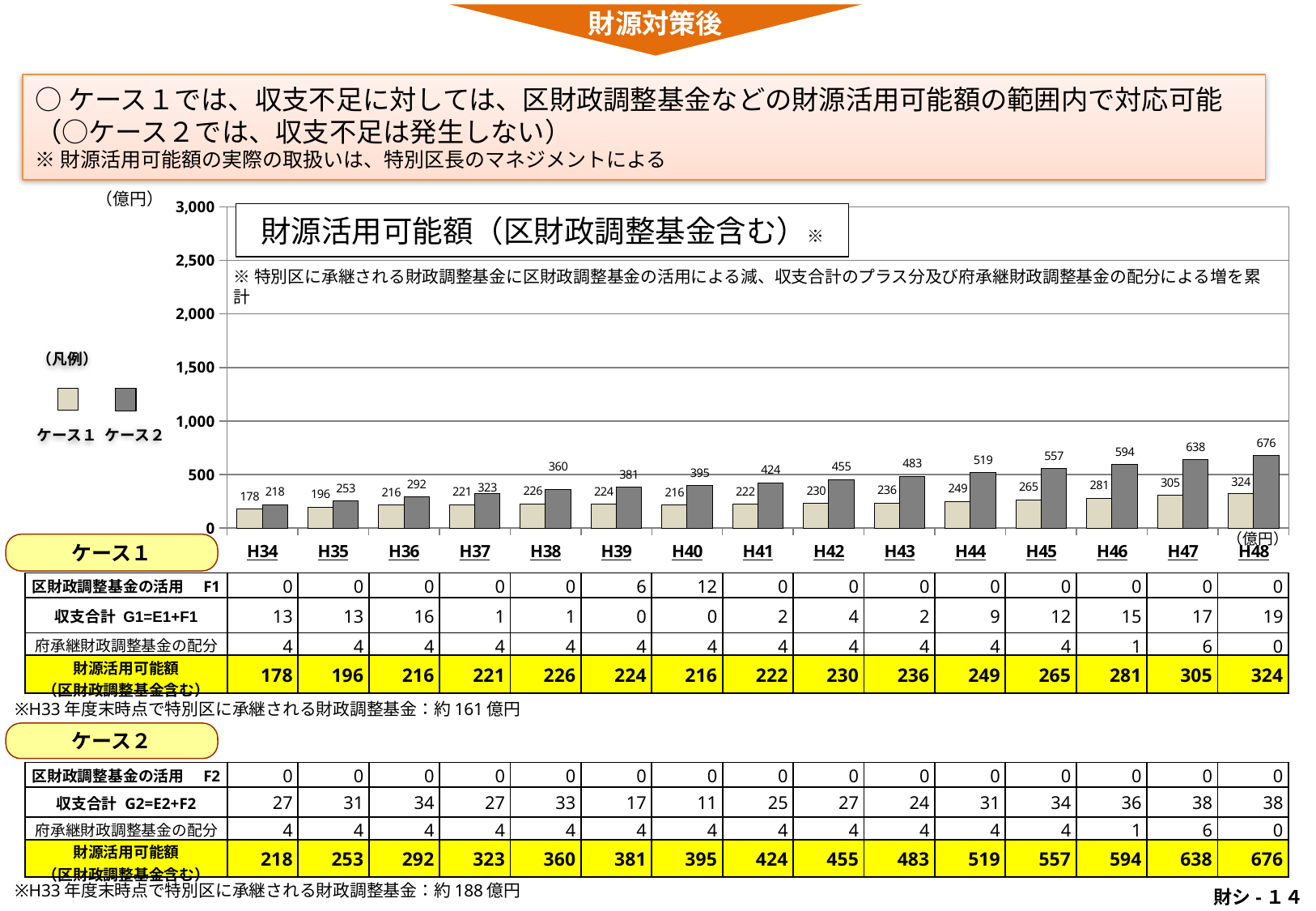
In which year is the value for ケース１ the lowest? H34 What is the value for ケース１ in H40? 216 How many series does the legend list? 2 In H38, which is larger, ケース１ or ケース２? ケース２ Do the values for ケース２ rise or fall from H34 to H48? rise Is the value for ケース２ in H48 greater or less than 500? greater How many years are shown on the x axis of the chart? 15 In which year does ケース２ reach its highest value? H48 What kind of chart is shown on the slide? bar chart By how much does the ケース１ value in H48 exceed the ケース１ value in H34? 146 What is the difference between ケース２ and ケース１ in H48? 352 What is the value for ケース２ in H45? 557